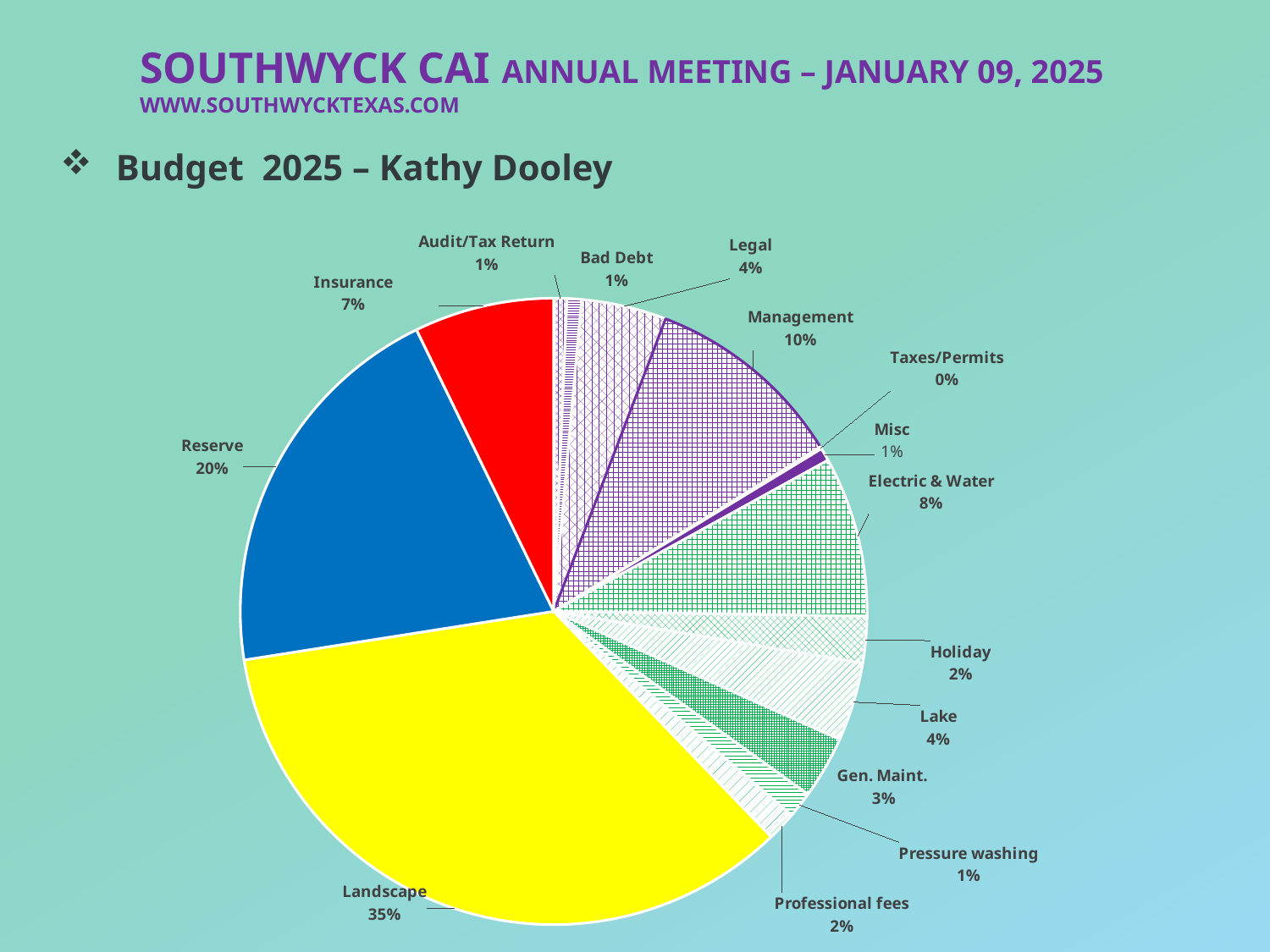
How many categories are shown in the pie chart? 15 Which is larger, the share for Insurance or the share for Electric & Water? Electric & Water What is the difference between the Management share and the Legal share? 6% What percentage is shown for Electric & Water? 8% What percentage of the budget is allocated to Reserve? 20% What share of the 2025 budget goes to Landscape? 35% Which category has the largest share of the budget? Landscape What percentage is shown for Lake? 4% What is the difference between the Landscape share and the Reserve share? 15% What kind of chart is shown on the slide? pie chart What is the value shown for Management? 10% Which category has the smallest share of the budget? Taxes/Permits